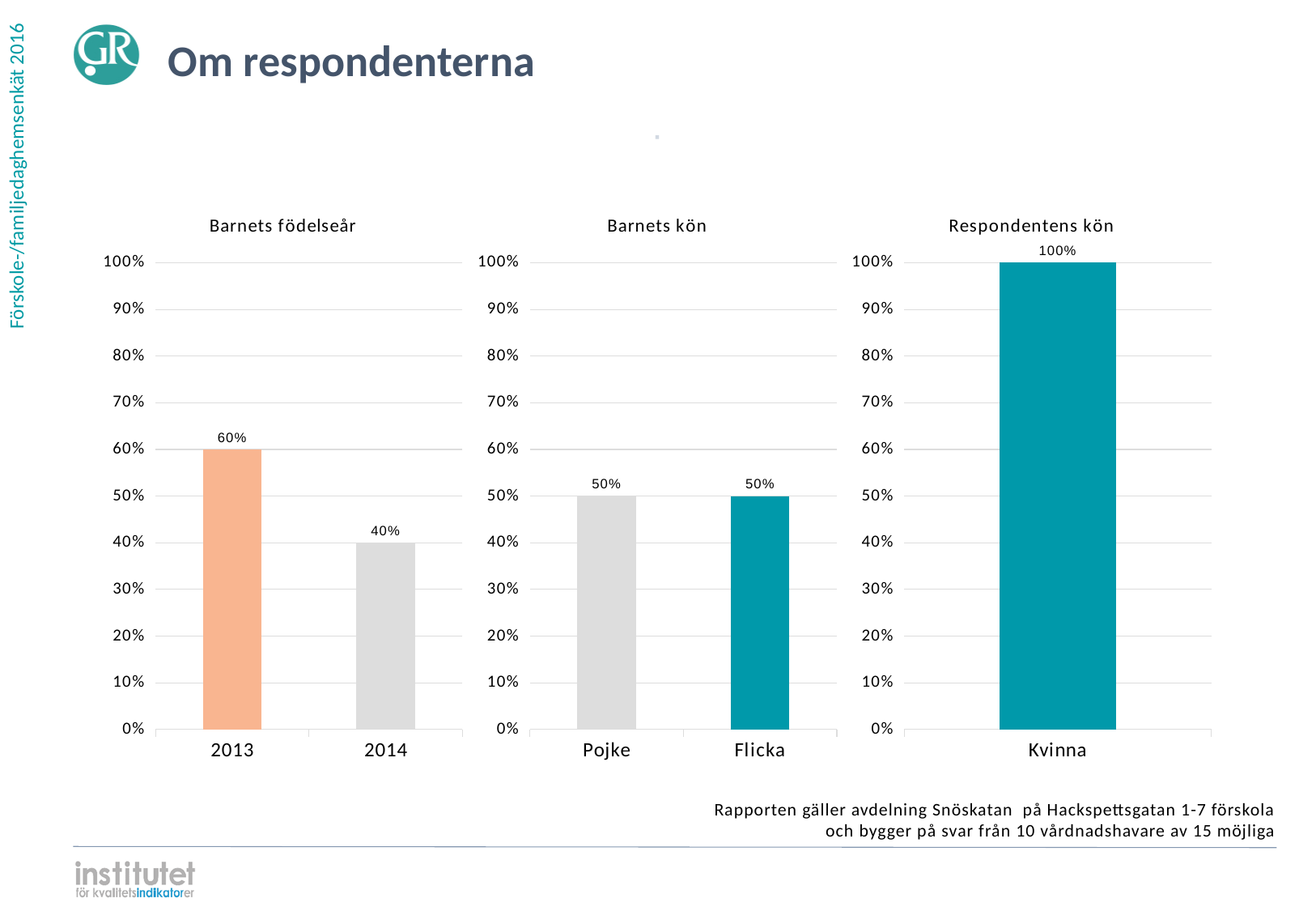
What is the title of the rightmost chart on the slide? Respondentens kön In the 'Barnets födelseår' chart, what is the value for 2013? 60% In the 'Barnets födelseår' chart, which category has the highest value? 2013 In the 'Barnets födelseår' chart, how many categories are shown? 2 In the 'Barnets kön' chart, what is the value for Flicka? 50% In the 'Respondentens kön' chart, how many categories are shown? 1 In the 'Barnets födelseår' chart, what is the value for 2014? 40% In the 'Barnets kön' chart, what is the difference between the values for Pojke and Flicka? 0% In the 'Barnets kön' chart, what is the value for Pojke? 50% In the 'Respondentens kön' chart, what is the value for Kvinna? 100% What kind of chart is the 'Barnets kön' chart? Bar chart In the 'Barnets födelseår' chart, what is the difference between the values for 2013 and 2014? 20%